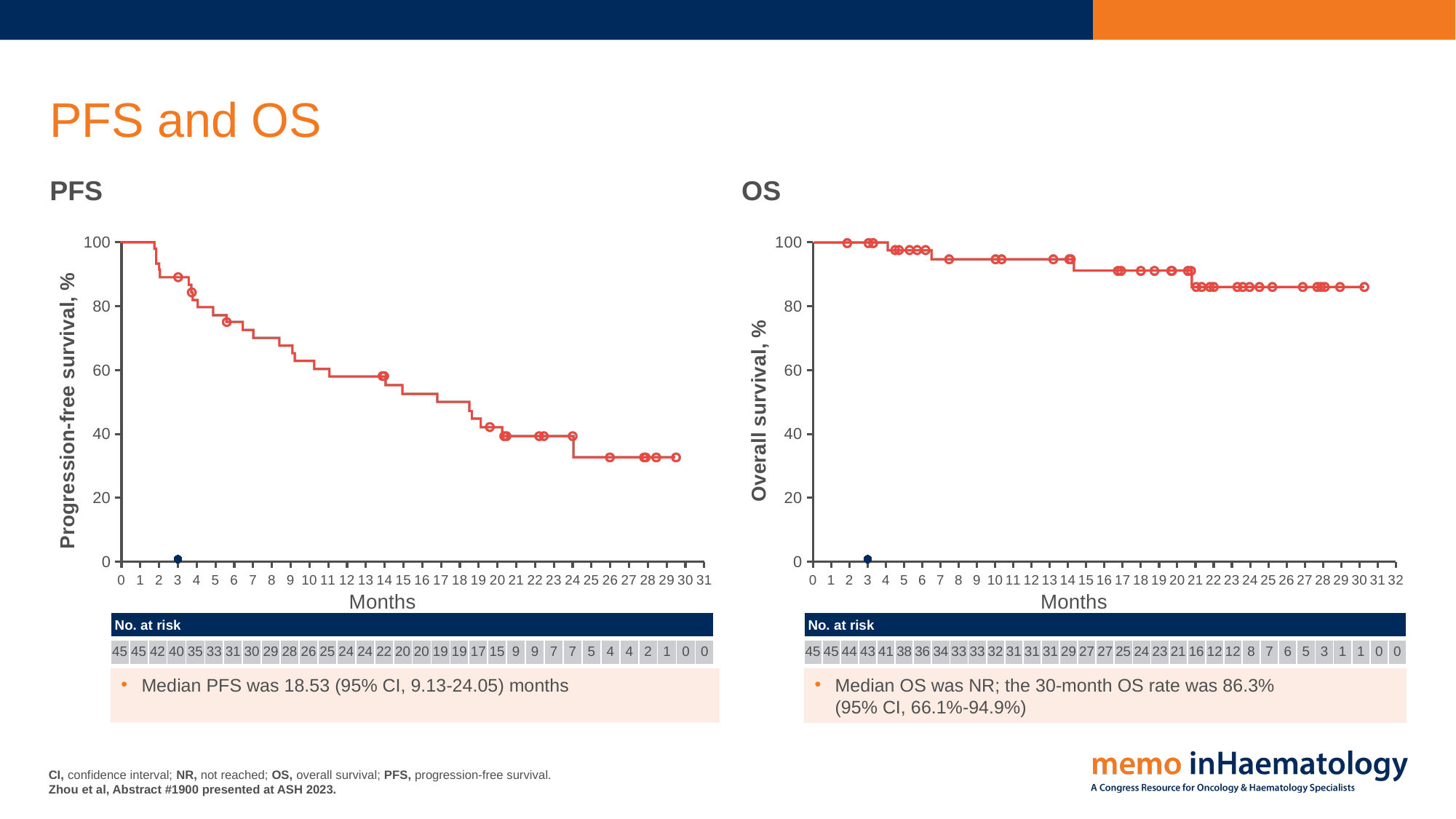
On the OS chart, what is the difference between the number at risk at month 0 and at month 20? 24 On the PFS chart, is the progression-free survival at month 28 greater or less than 40? less On the OS chart, how many patients are at risk at month 20? 21 At month 10, which chart shows more patients at risk, PFS or OS? OS On the PFS chart, is the progression-free survival at month 8 greater or less than 60? greater What kind of chart is the PFS chart on the left? line chart On the PFS chart, how many patients are at risk at month 0? 45 On the OS chart, how many patients are at risk at month 30? 1 According to the slide, what was the median PFS? 18.53 months On the PFS chart, how many patients are at risk at month 10? 26 On the OS chart, is the overall survival at month 30 greater or less than 80? greater On the PFS chart, does the survival curve rise or fall as months increase? fall